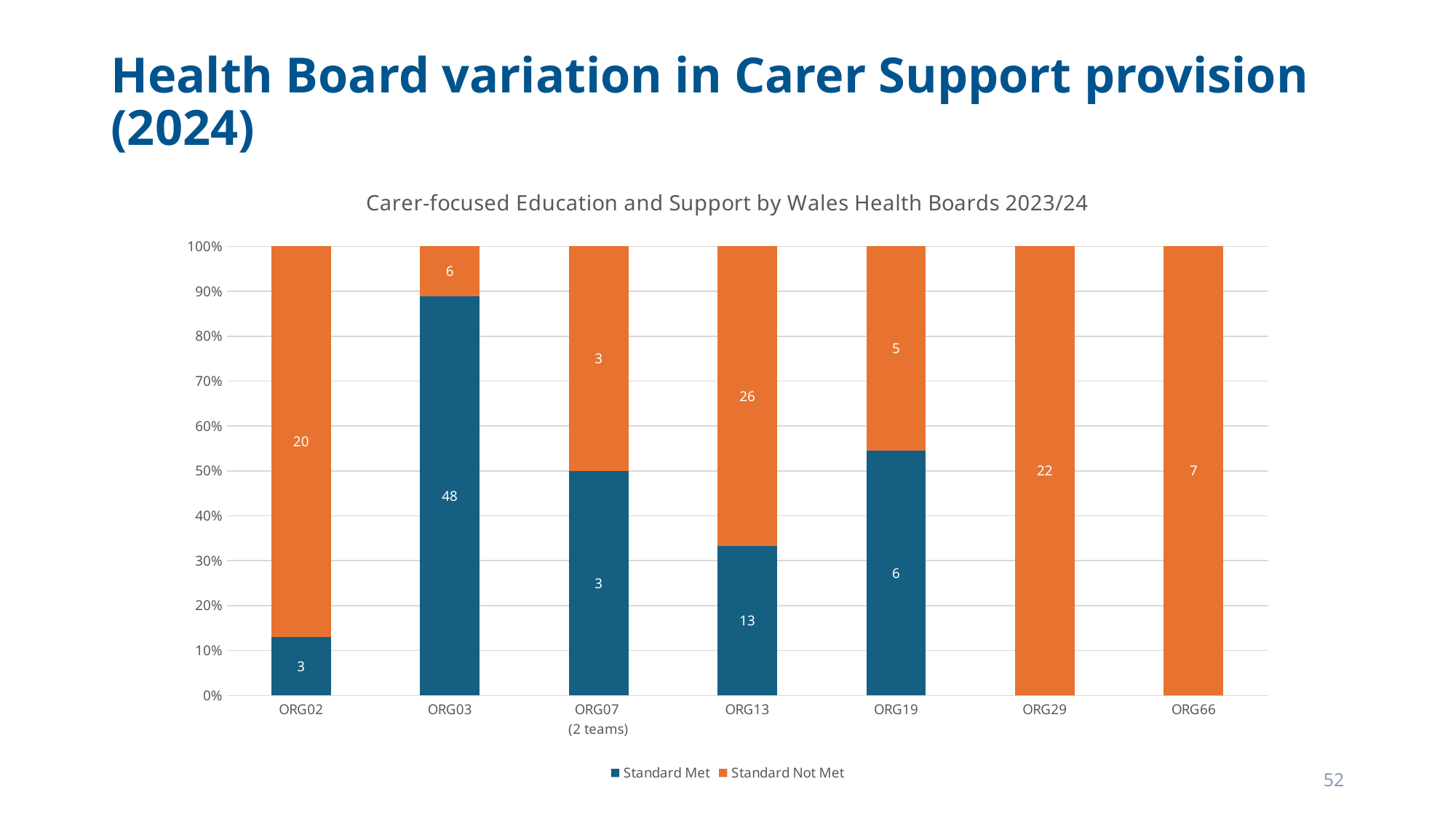
Is the Standard Met share of the ORG03 bar greater or less than 80%? greater Which is larger for ORG19, Standard Met or Standard Not Met? Standard Met What is the total of the Standard Met and Standard Not Met values for ORG13? 39 What is the Standard Met value for ORG03? 48 What is the difference between the Standard Not Met and Standard Met values for ORG02? 17 What is the Standard Not Met value for ORG13? 26 What is the Standard Not Met value for ORG29? 22 Which organisation has the highest Standard Met value? ORG03 What kind of chart is shown on the slide? Stacked bar chart How many organisations are shown on the x axis? 7 Which organisation has the lowest Standard Not Met value? ORG07 (2 teams) How many series does the legend list? 2